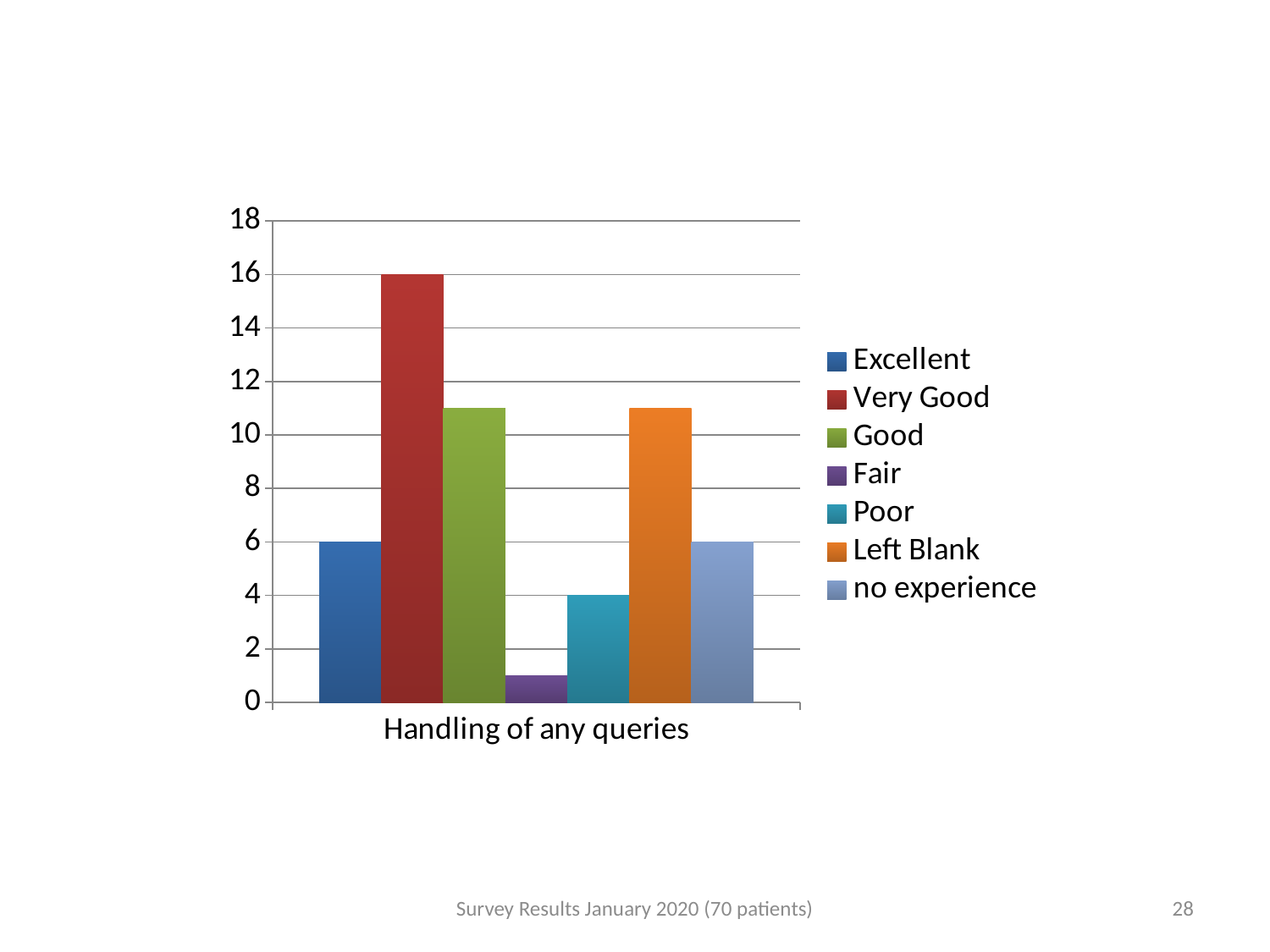
Which rating has the highest value? Very Good What is the value for Very Good? 16 Which is larger, the value for Very Good or the value for Good? Very Good What type of chart is shown on the slide? bar chart What is the value for Excellent? 6 What is the category label shown on the x axis? Handling of any queries Which rating has the lowest value? Fair What is the value for Poor? 4 Is the value for Fair greater or less than 2? less Is the value for Good greater or less than 10? greater What is the difference between the values for Very Good and Excellent? 10 How many series does the legend list? 7